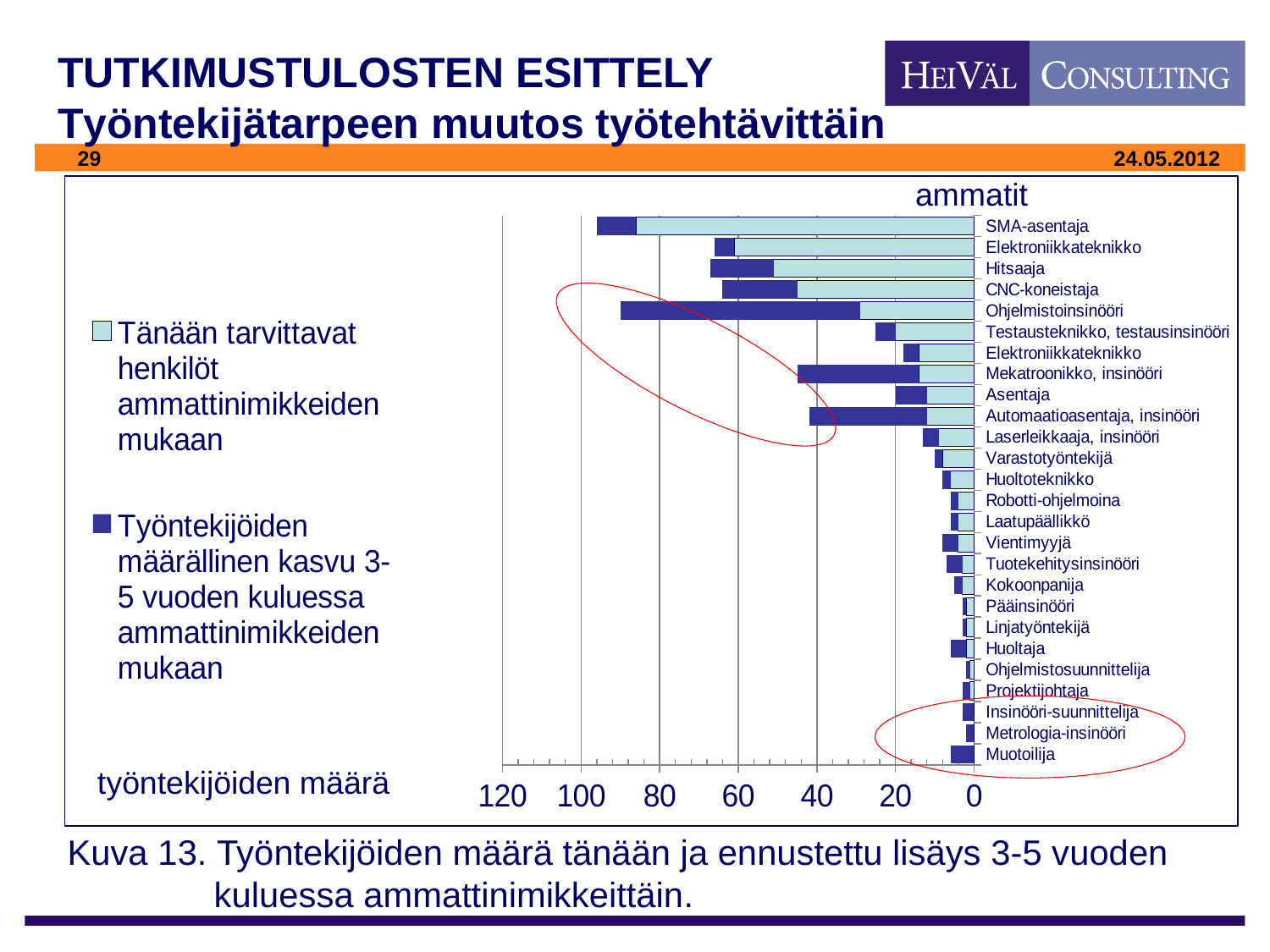
What is the label written under the horizontal axis of the chart? työntekijöiden määrä Which has the longer total bar, Hitsaaja or Asentaja? Hitsaaja Which occupation has the longest total bar? SMA-asentaja Is the total bar for SMA-asentaja greater or less than 80? greater Which has the longer total bar, Ohjelmistoinsinööri or Laserleikkaaja, insinööri? Ohjelmistoinsinööri What kind of chart is shown on the slide? bar chart Is the total bar for Hitsaaja greater or less than 60? greater How many occupation categories are plotted on the chart? 26 Which occupation has the largest dark blue segment (growth in 3-5 years)? Ohjelmistoinsinööri How many series does the legend list? 2 Which legend entry is shown with the dark blue colour? Työntekijöiden määrällinen kasvu 3-5 vuoden kuluessa ammattinimikkeiden mukaan Is the total bar for Muotoilija greater or less than 20? less